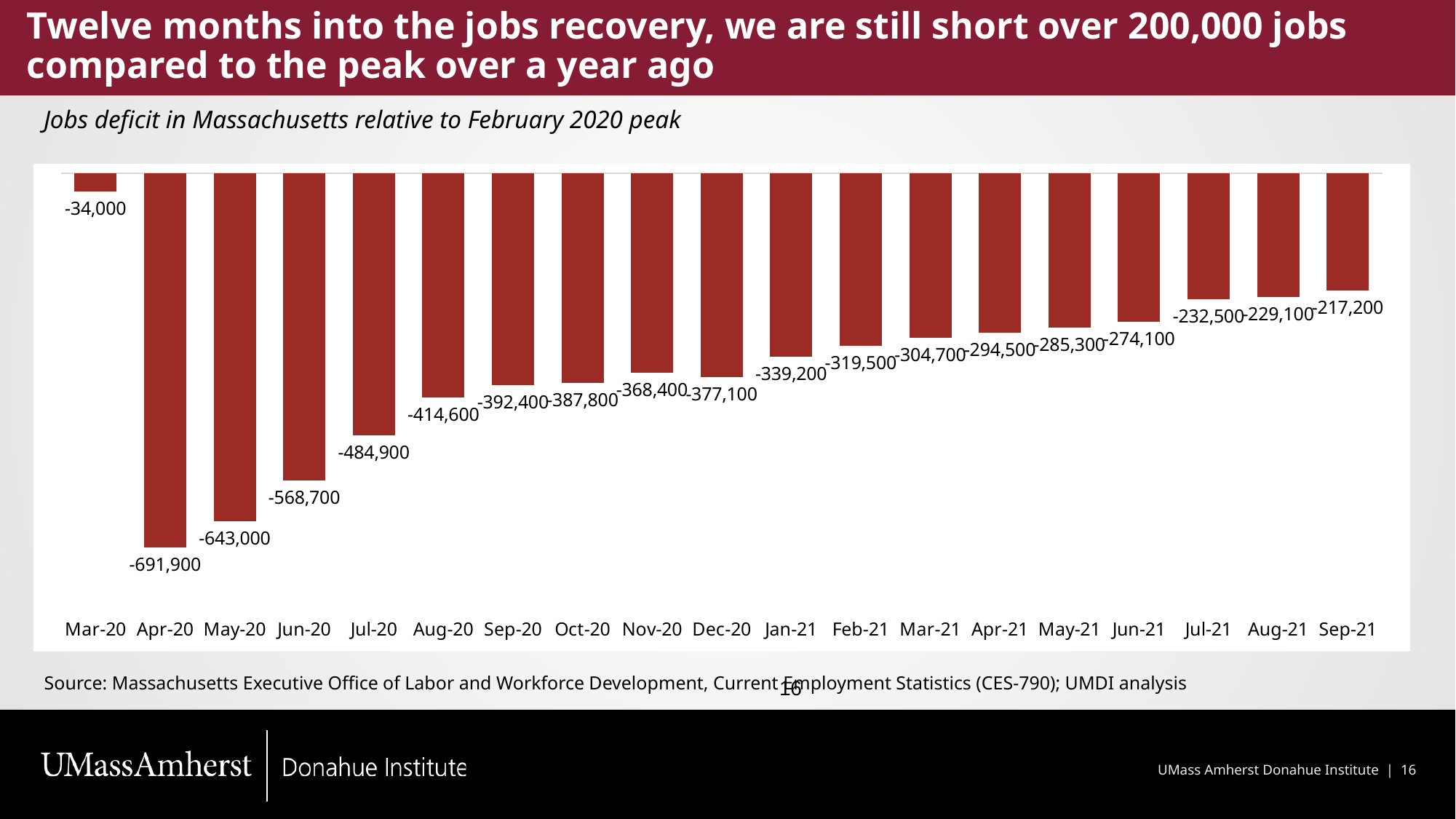
What type of chart is shown on the slide? Bar chart What is the difference between the Nov-20 value (-368,400) and the Dec-20 value (-377,100)? 8,700 How many months are plotted on the chart? 19 Which month has the largest jobs deficit (the most negative value)? Apr-20 From Apr-20 to Sep-21, does the jobs deficit generally shrink or grow? Shrink What value is labeled on the bar for Dec-20? -377,100 Which month has the smallest jobs deficit (the value closest to zero)? Mar-20 What is the jobs deficit value shown for Apr-20? -691,900 What is the jobs deficit value shown for Sep-21? -217,200 What value is labeled on the bar for Mar-21? -304,700 Which month has a larger jobs deficit, Nov-20 or Dec-20? Dec-20 By how much did the jobs deficit shrink between Apr-20 and Sep-21? 474,700